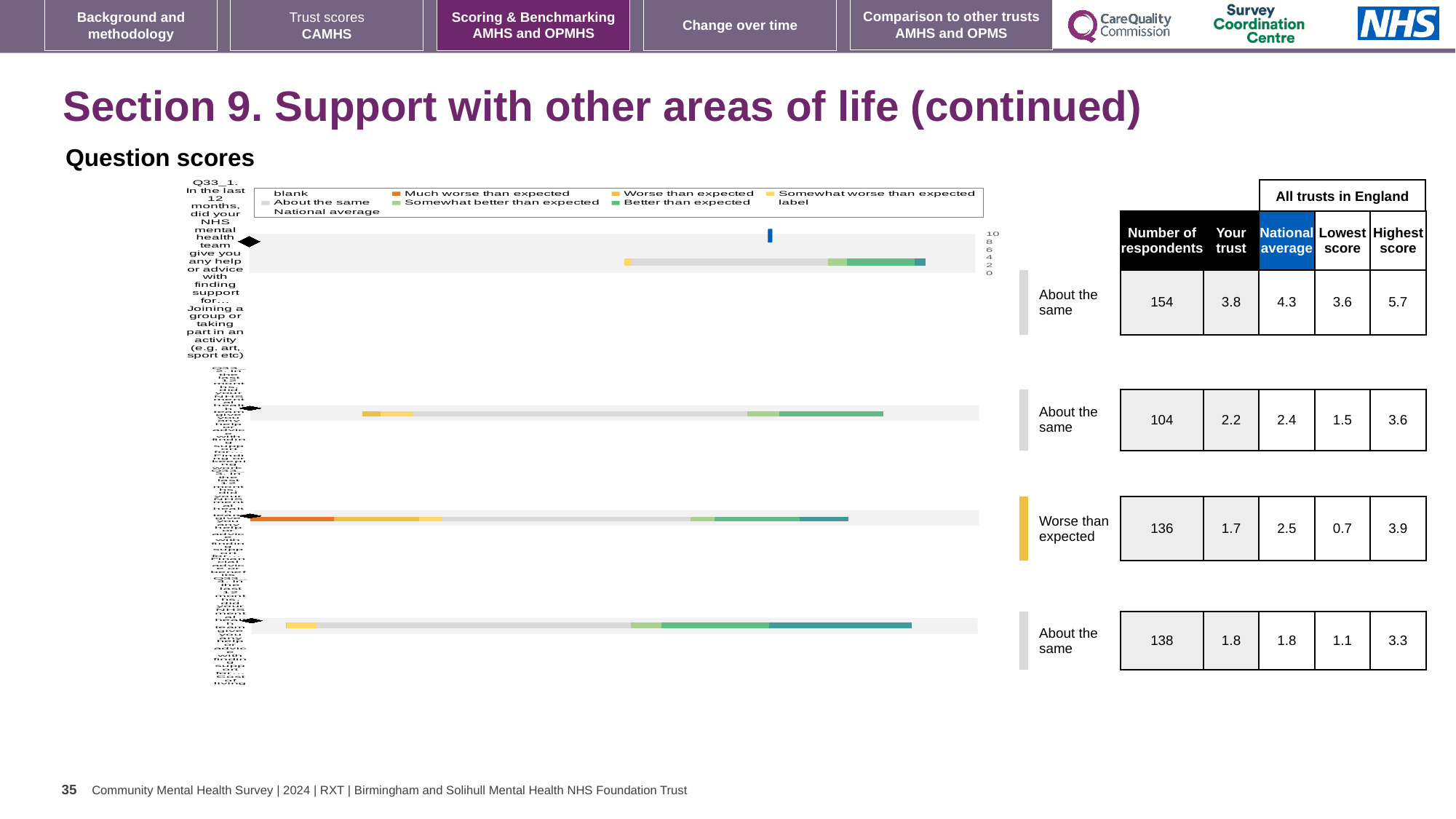
How many question bars are plotted in the chart? 4 In the table beside the chart, which row has the highest number of respondents? The first row (154) In the table beside the chart, what is the difference between the national average and the 'Your trust' score for the first question (Q33_1)? 0.5 How many of the four question rows are rated 'About the same'? 3 Which legend entry is shown in orange? Much worse than expected What kind of chart is shown on the slide? bar chart How many entries does the chart's legend list? 9 For the first question (Q33_1), which is larger: the 'Your trust' score or the national average? National average In the table beside the chart, what is the lowest score for the third question row? 0.7 Which rating label is shown for the third question row? Worse than expected In the table beside the chart, what is the 'Your trust' score for the first question (Q33_1, joining a group or taking part in an activity)? 3.8 In the table beside the chart, what is the national average for the first question (Q33_1)? 4.3